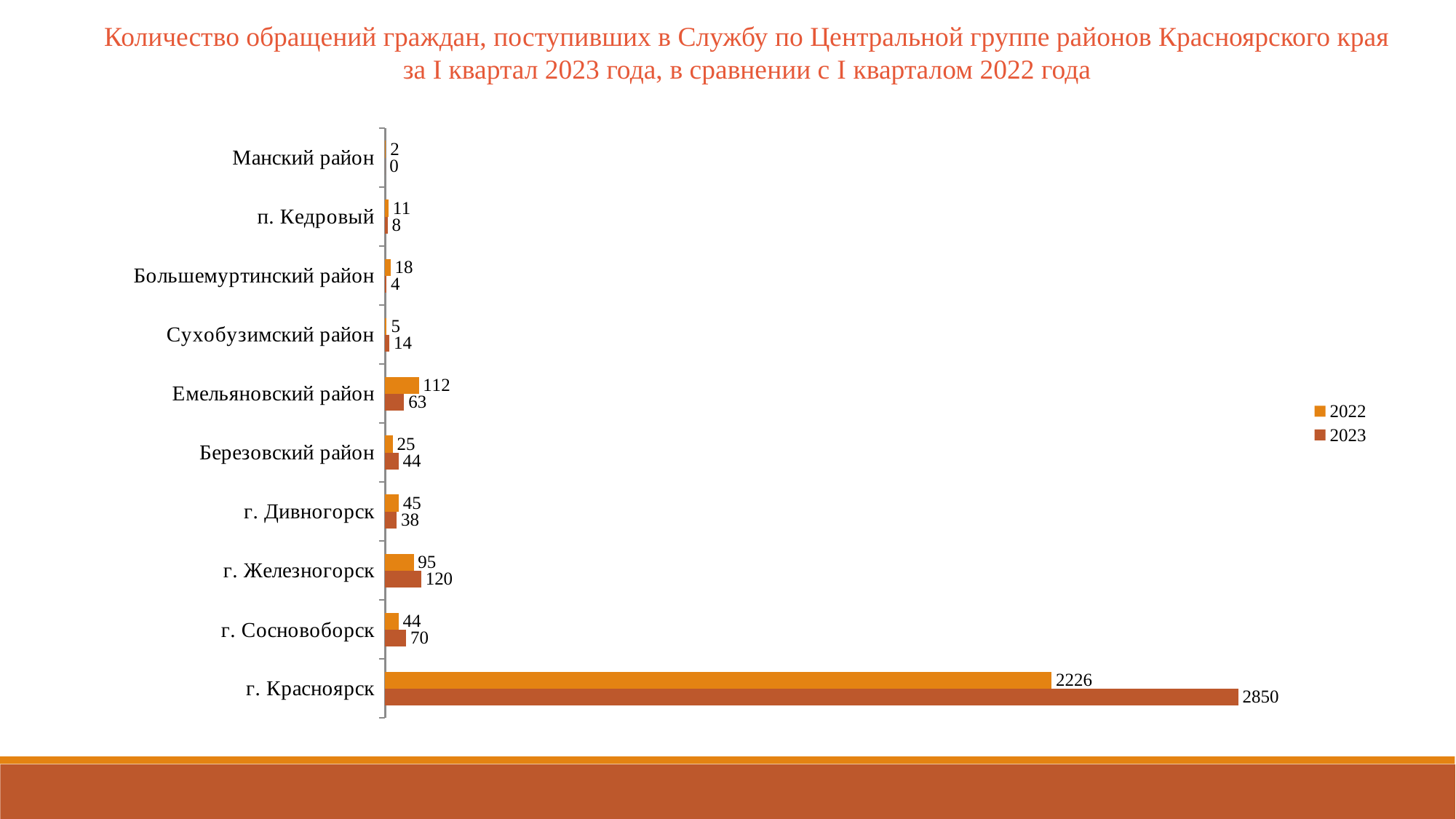
What is the difference between the 2023 and 2022 values for г. Красноярск? 624 What is the value for г. Железногорск in the 2023 series? 120 Which is larger for г. Сосновоборск, the 2022 value or the 2023 value? 2023 Which is larger for г. Дивногорск, the 2022 value or the 2023 value? 2022 What is the value for Емельяновский район in the 2022 series? 112 Which category has the highest value in the 2022 series? г. Красноярск How many categories are shown on the chart? 10 What is the value for г. Красноярск in the 2023 series? 2850 What is the difference between the 2022 and 2023 values for Емельяновский район? 49 What kind of chart is shown on the slide? Bar chart How many series does the legend list? 2 Which category has the lowest value in the 2023 series? Манский район